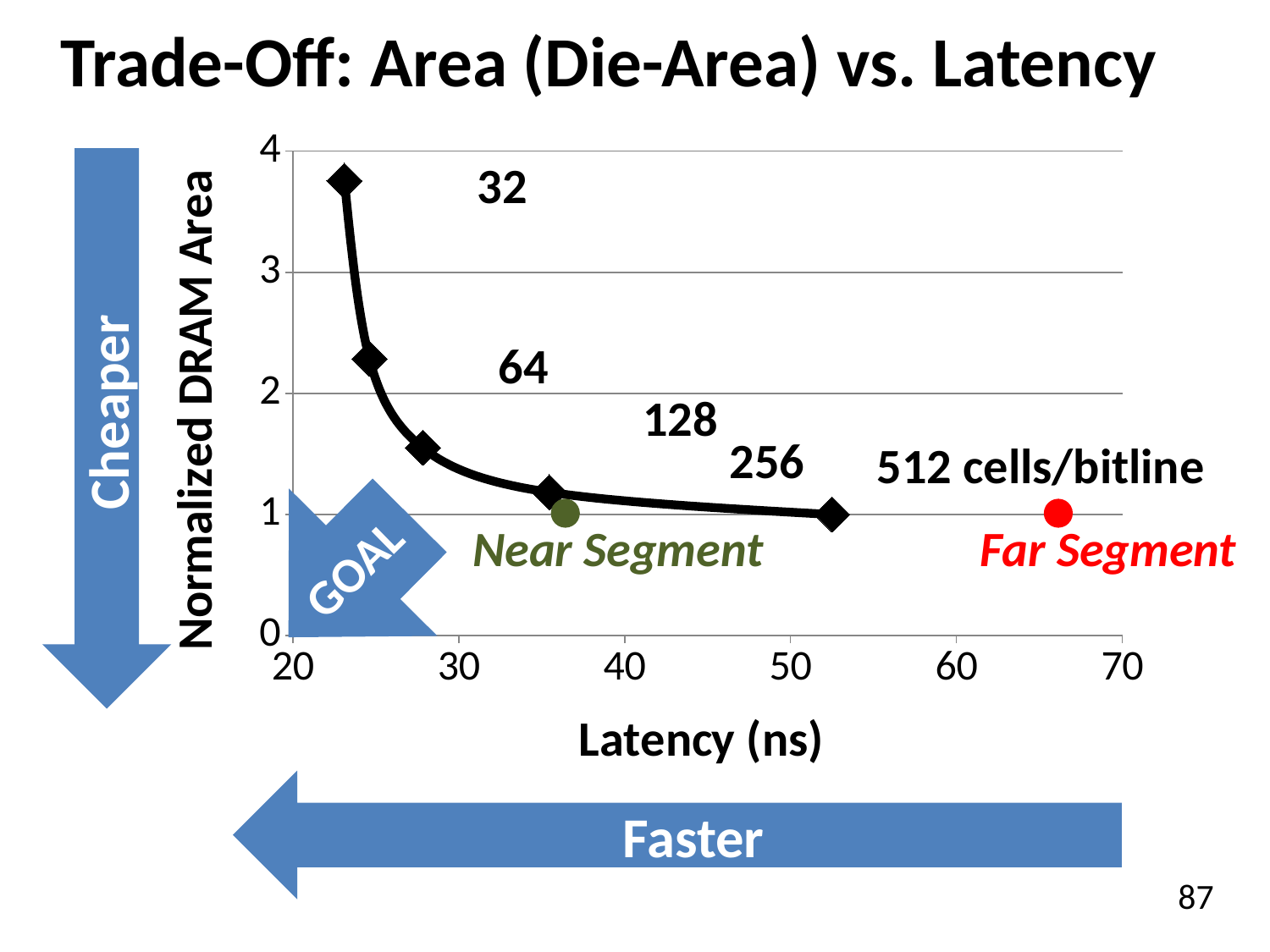
Is the normalized DRAM area for 128 cells/bitline greater or less than 2? less Which cells/bitline configuration has the highest latency? 512 What kind of chart is shown on the slide? line chart As latency increases along the x axis, does the normalized DRAM area rise or fall? fall What is the title of the x axis? Latency (ns) Which has a larger normalized DRAM area, 64 cells/bitline or 128 cells/bitline? 64 cells/bitline Is the latency of the Far Segment point greater or less than 60 ns? greater How many cells/bitline data points (diamonds) are plotted on the black curve? 5 Is the latency of the Near Segment point greater or less than 40 ns? less Which cells/bitline configuration has the lowest normalized DRAM area? 512 Which cells/bitline configuration has the highest normalized DRAM area? 32